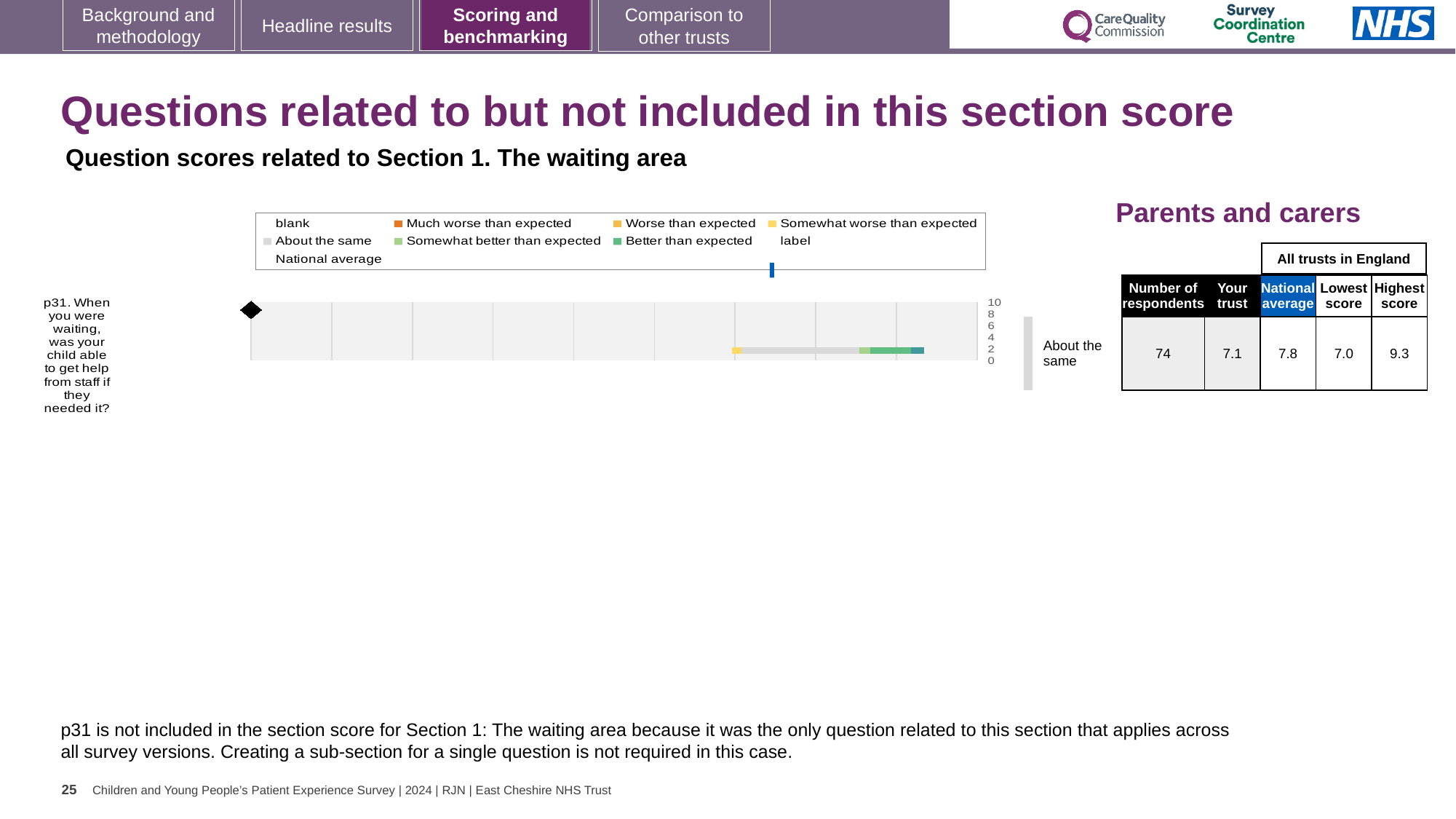
What is the lowest score among all trusts in England for p31? 7.0 What is the national average score for p31 shown in the table beside the chart? 7.8 What kind of chart is shown on the slide? bar chart How many entries does the chart legend list? 9 What is the difference between the highest score (9.3) and the lowest score (7.0) for p31? 2.3 How many questions (categories) are plotted in the chart? 1 Which question number is plotted in the chart? p31 What is the 'Your trust' score for p31 shown in the table beside the chart? 7.1 Which is larger for p31: the 'Your trust' score or the national average? National average What is the highest score among all trusts in England for p31? 9.3 What benchmark rating is shown next to the bar for p31? About the same How many respondents answered p31? 74